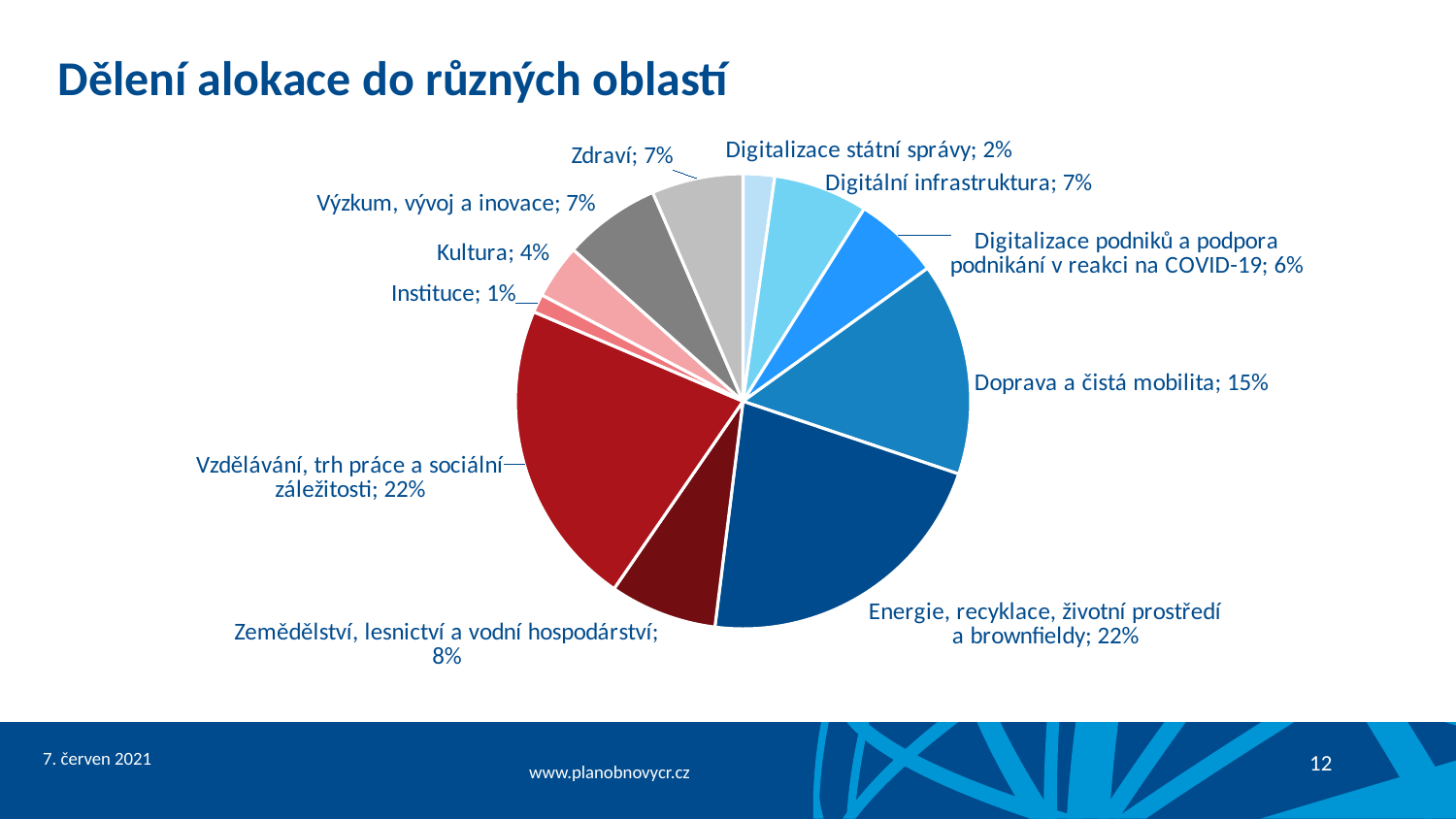
What is the value shown for "Kultura"? 4% What is the difference between the shares of "Vzdělávání, trh práce a sociální záležitosti" and "Zdraví"? 15% What is the value shown for "Digitalizace státní správy"? 2% Which is larger: the share for "Digitální infrastruktura" or the share for "Digitalizace podniků a podpora podnikání v reakci na COVID-19"? Digitální infrastruktura Which category has the smallest slice of the pie? Instituce What is the value shown for "Energie, recyklace, životní prostředí a brownfieldy"? 22% What kind of chart is shown on the slide? pie chart What is the difference between the shares of "Doprava a čistá mobilita" and "Zemědělství, lesnictví a vodní hospodárství"? 7% How many categories (slices) does the pie chart have? 11 What share of the pie does "Doprava a čistá mobilita" have? 15% What share of the pie does "Zemědělství, lesnictví a vodní hospodárství" have? 8% What is the title of the chart on the slide? Dělení alokace do různých oblastí